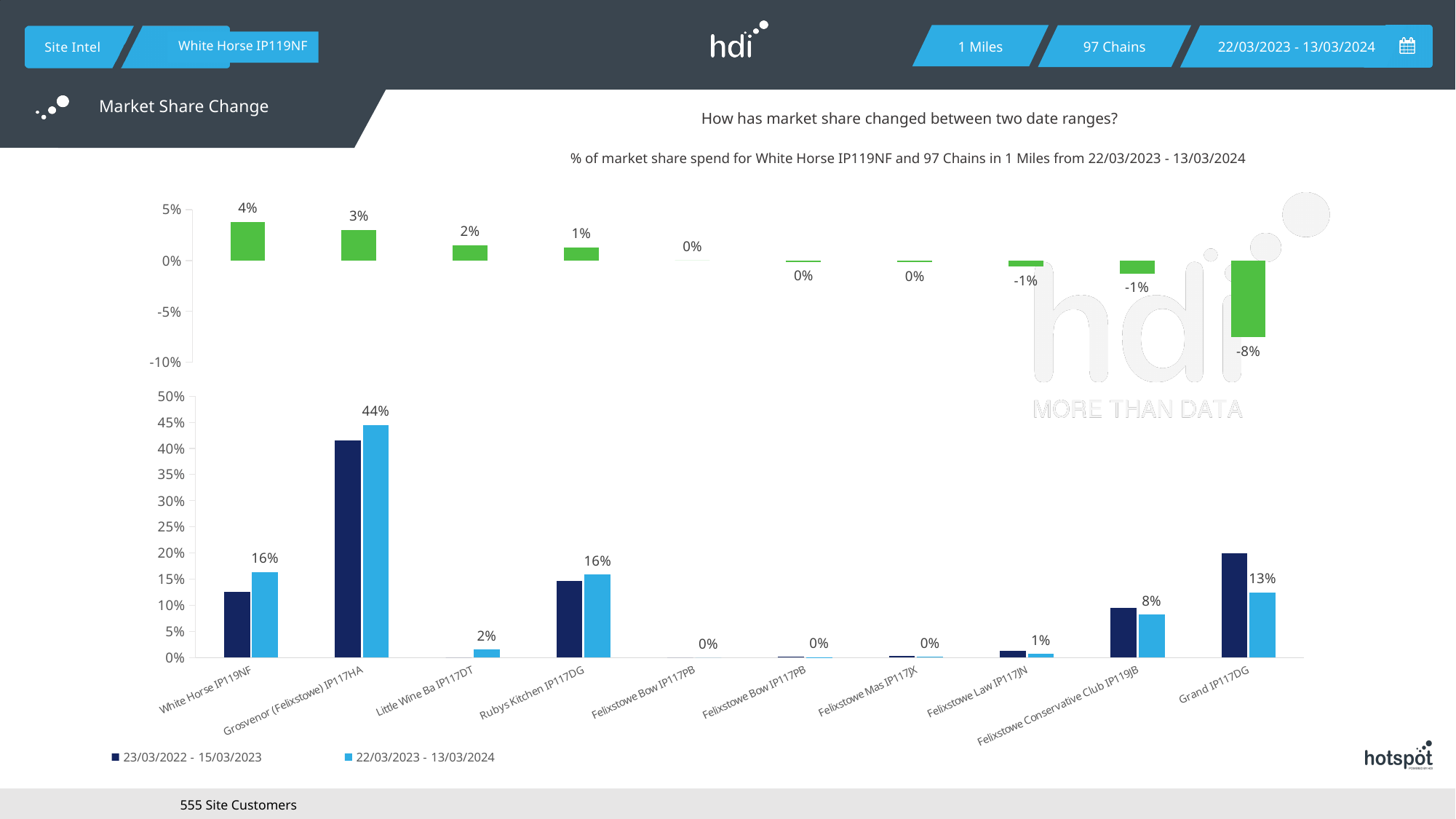
In the bottom chart, what is the market share for Felixstowe Conservative Club IP119JB in 22/03/2023 - 13/03/2024? 8% In the bottom chart, for Grand IP117DG, which period has the larger market share: 23/03/2022 - 15/03/2023 or 22/03/2023 - 13/03/2024? 23/03/2022 - 15/03/2023 In the bottom chart, what is the market share for Grosvenor (Felixstowe) IP117HA in 22/03/2023 - 13/03/2024? 44% In the top chart, what is the difference between the market share change for White Horse IP119NF and Grosvenor (Felixstowe) IP117HA? 1% In the top chart, which category has the lowest market share change? Grand IP117DG In the bottom chart, is the market share for Grand IP117DG in 23/03/2022 - 15/03/2023 greater or less than 15%? greater In the top chart, what is the market share change for Grand IP117DG? -8% In the top chart, what is the market share change for White Horse IP119NF? 4% In the top chart, which category has the highest market share change? White Horse IP119NF How many series does the legend of the bottom chart list? 2 How many categories are shown on the x axis of the bottom chart? 10 In the bottom chart, which category has the highest market share in 22/03/2023 - 13/03/2024? Grosvenor (Felixstowe) IP117HA